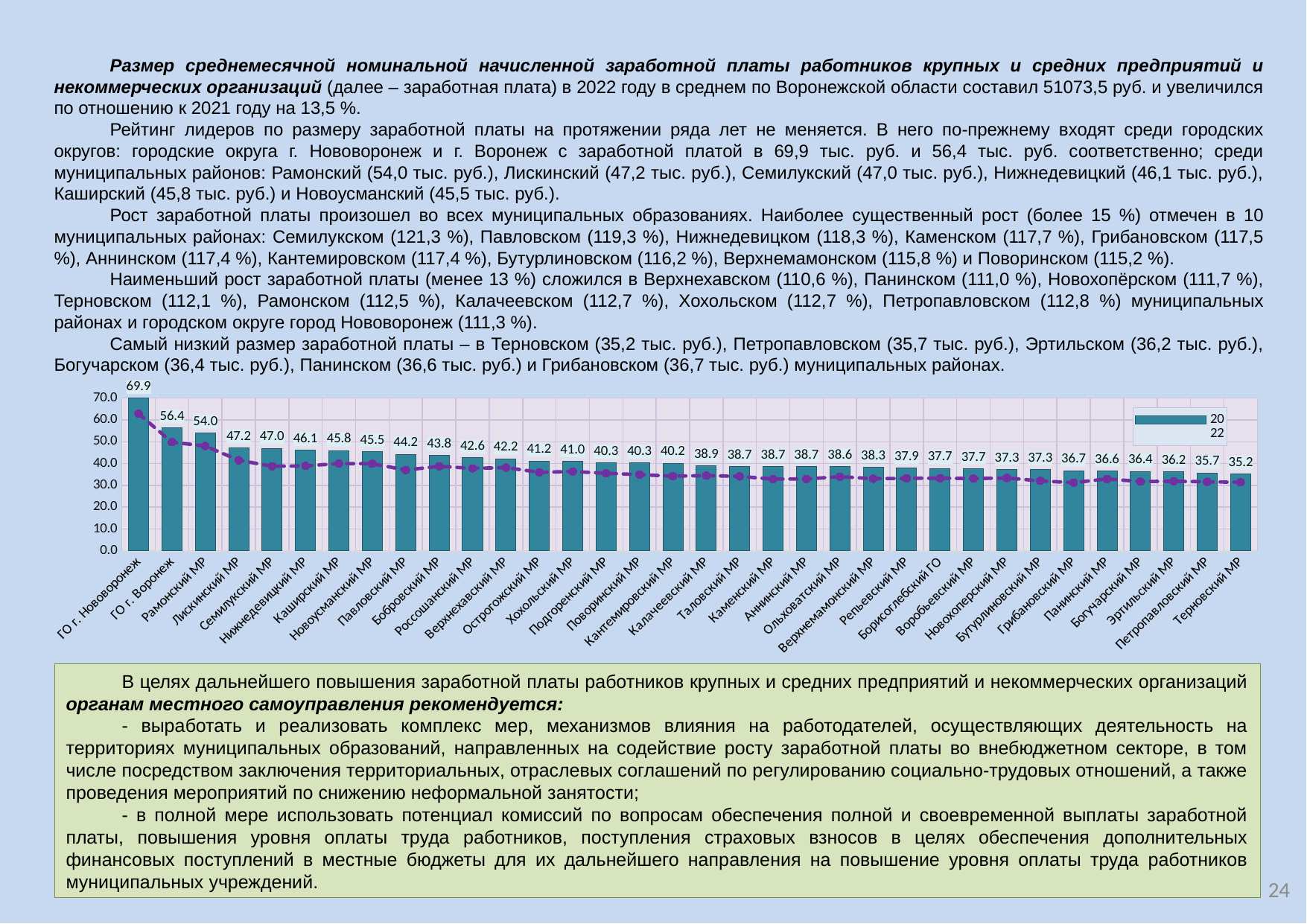
Do the bar values rise or fall from left to right along the x axis? fall Is the value of the dashed line for ГО г. Нововоронеж greater or less than 50.0? greater How many categories are shown on the x axis of the chart? 34 What is the difference between the bar values for ГО г. Нововоронеж and ГО г. Воронеж? 13.5 What is the value shown for Рамонский МР in the bar chart? 54.0 What is the value shown for Терновский МР in the bar chart? 35.2 What is the value shown for Каширский МР in the bar chart? 45.8 What is the value shown for ГО г. Нововоронеж in the bar chart? 69.9 What kind of chart is shown on the slide? bar chart with a line Which category has the lowest bar in the chart? Терновский МР Which has a larger bar value, Лискинский МР or Павловский МР? Лискинский МР Which category has the highest bar in the chart? ГО г. Нововоронеж